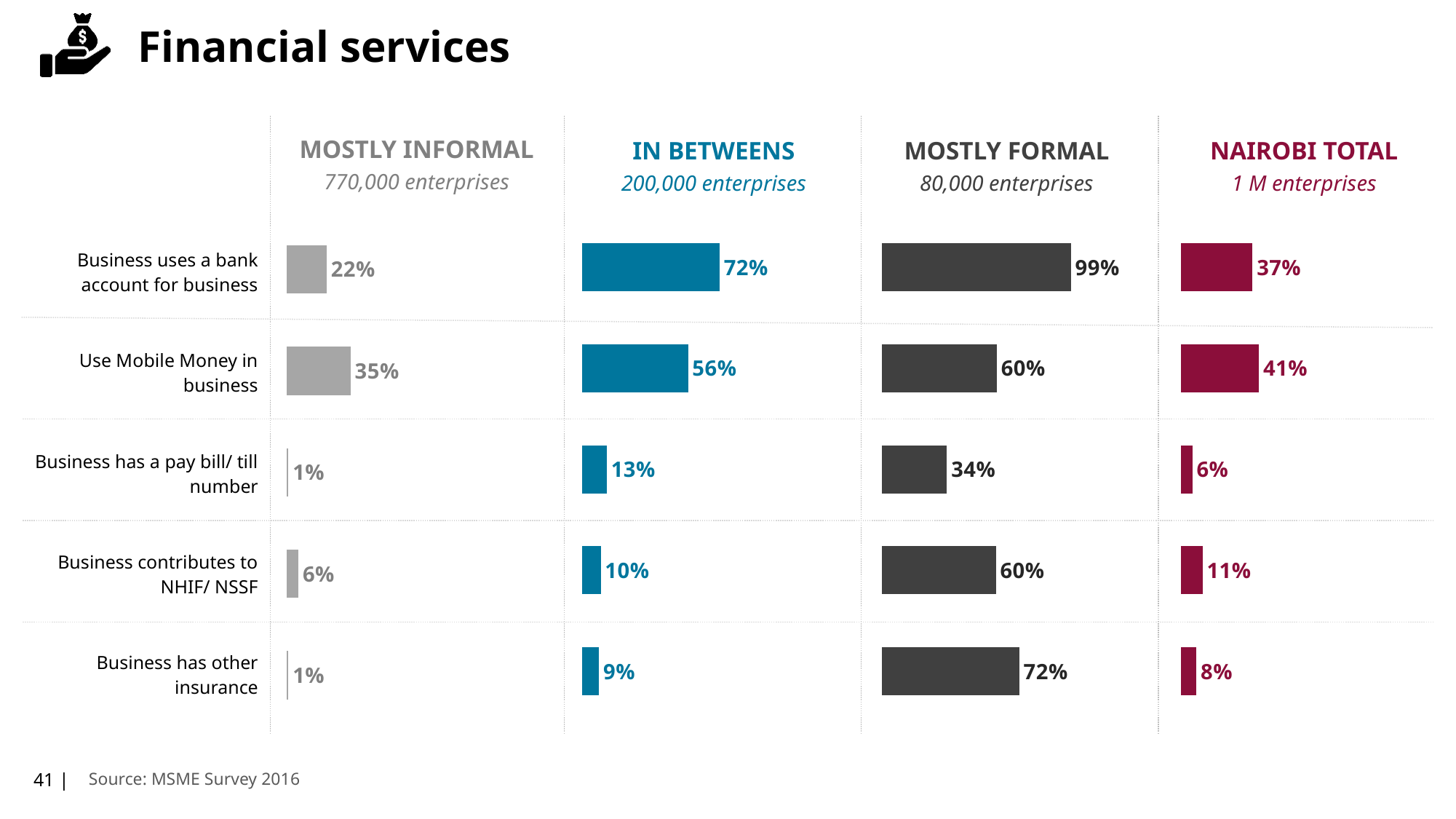
In the Nairobi Total chart, what is the value for 'Use Mobile Money in business'? 41% In the Mostly Informal chart, what percentage of businesses use a bank account for business? 22% In the In Betweens chart, which category has the highest value? Business uses a bank account for business What colour are the bars in the Nairobi Total chart? Dark red In the Mostly Informal chart, what is the difference between 'Use Mobile Money in business' and 'Business contributes to NHIF/ NSSF'? 29% In the Nairobi Total chart, which category has the lowest value? Business has a pay bill/ till number In the In Betweens chart, which is larger: 'Use Mobile Money in business' or 'Business has a pay bill/ till number'? Use Mobile Money in business In the Mostly Formal chart, what is the value for 'Business has other insurance'? 72% How many enterprises does the In Betweens chart header say it covers? 200,000 enterprises In the Mostly Formal chart, what is the difference between 'Business uses a bank account for business' and 'Business has a pay bill/ till number'? 65% What kind of chart is used in the Mostly Informal column? Bar chart How many categories are shown in each chart on the slide? 5